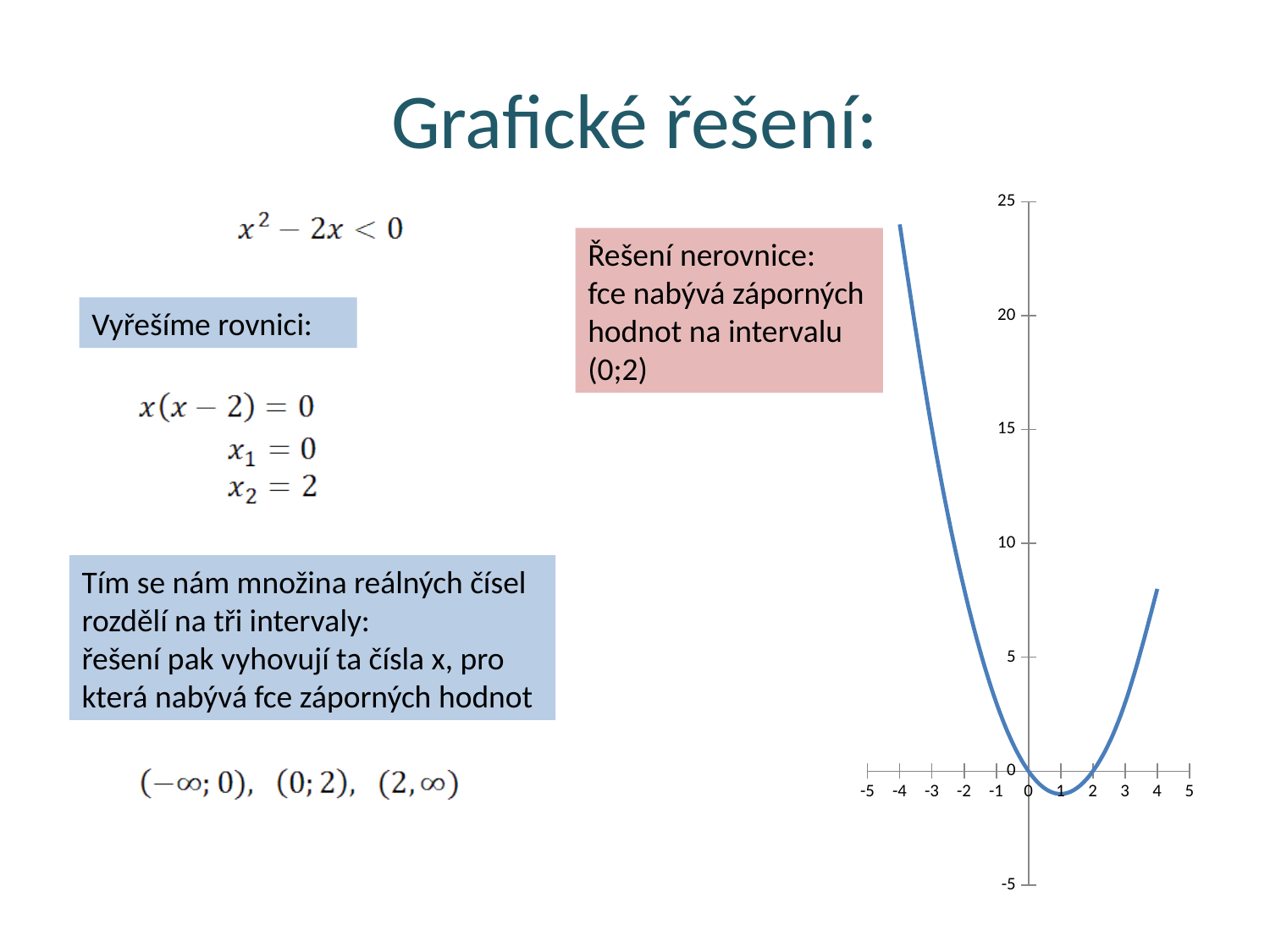
Is the value of the curve at x = 4 greater or less than 5? greater Is the value of the curve at x = 1 greater or less than 0? less Is the value of the curve at x = 4 greater or less than 10? less Do the values of the curve rise or fall as x goes from -4 to 0? fall Which is larger: the value of the curve at x = -4 or at x = 4? x = -4 Do the values of the curve rise or fall as x goes from 2 to 4? rise At which x values does the curve cross the x axis? 0 and 2 What kind of chart is shown on the slide? line chart How many lines (series) are plotted on the chart? 1 What is the highest value shown on the vertical axis of the chart? 25